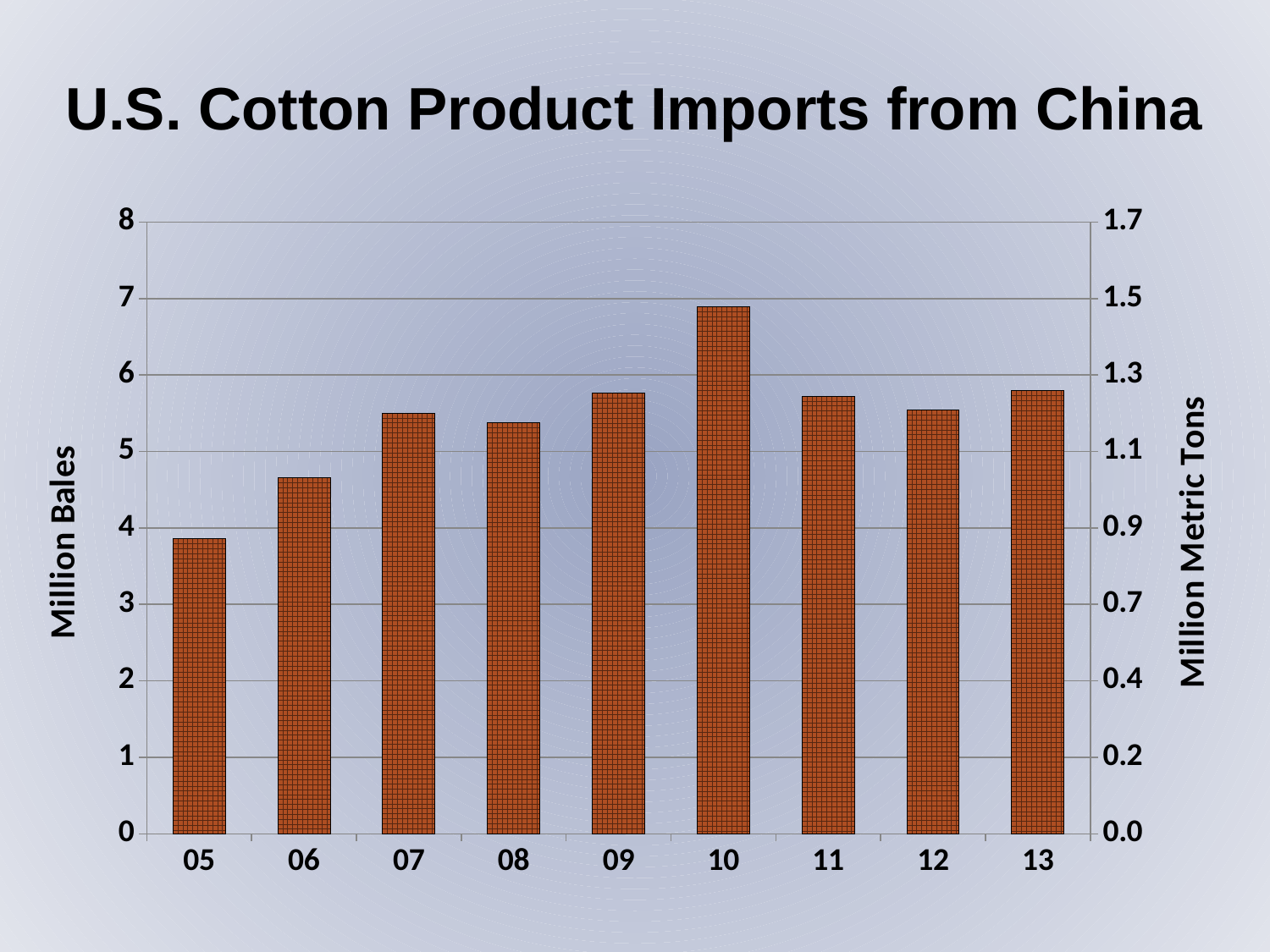
Is the value for 13 greater or less than 5 million bales? greater What kind of chart is shown on the slide? bar chart Which year has the larger value, 06 or 07? 07 Do the values rise or fall from 05 to 07? rise Is the value for 10 greater or less than 6 million bales? greater Which year has the lowest U.S. cotton product imports from China? 05 Which year has the larger value, 10 or 13? 10 Which year has the highest U.S. cotton product imports from China? 10 Is the value for 06 greater or less than 5 million bales? less How many years (bars) are plotted on the chart? 9 What is the label of the left vertical axis? Million Bales